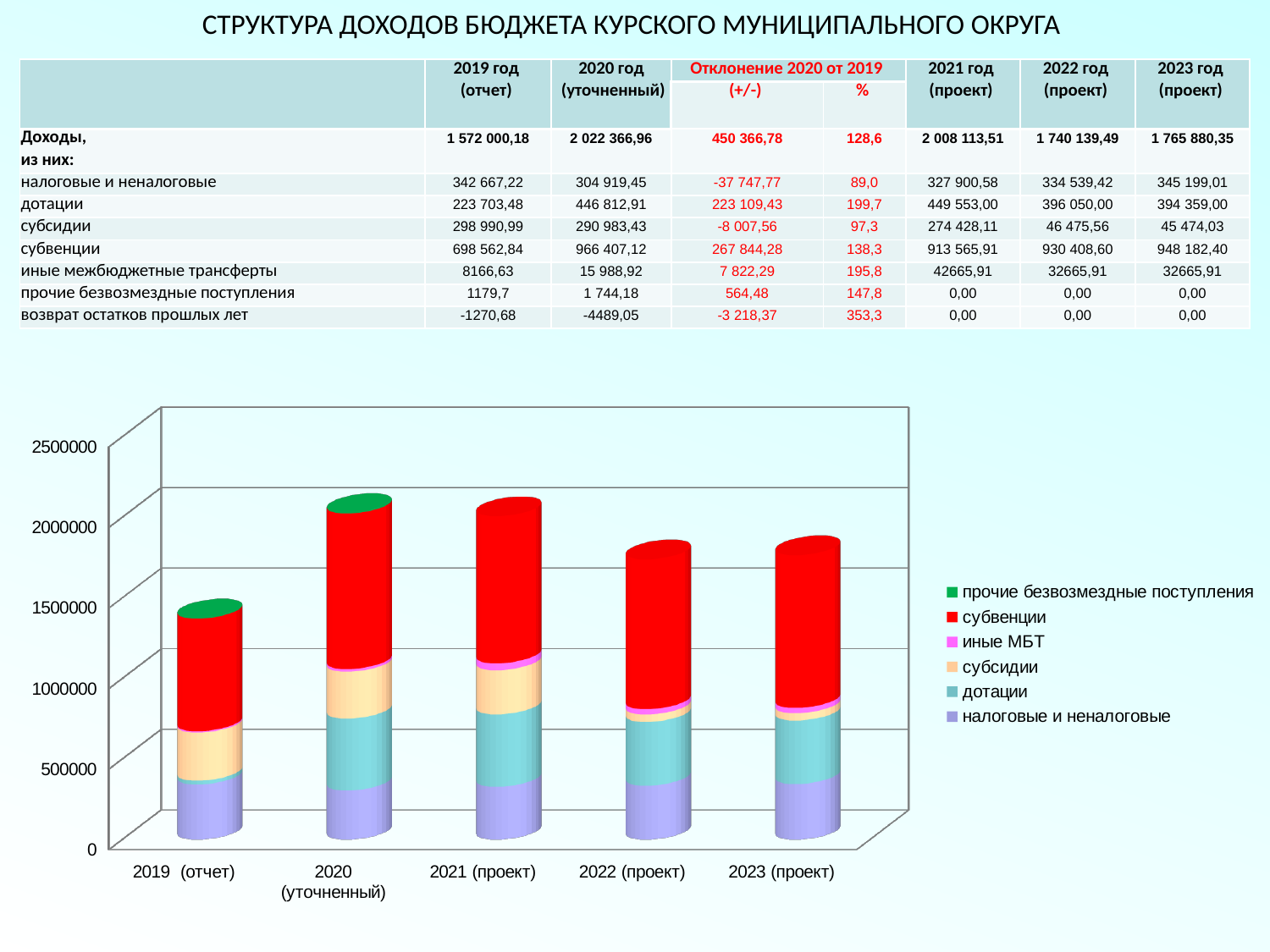
Which series is listed first in the chart legend? прочие безвозмездные поступления Does the total bar rise or fall from 2021 (проект) to 2022 (проект)? fall How many series does the chart legend list? 6 Is the total bar for 2019 (отчет) greater or less than 2000000? less How many year categories are shown along the x axis of the chart? 5 Which total bar is taller, 2019 (отчет) or 2022 (проект)? 2022 (проект) What kind of chart is shown on the slide? bar chart Which total bar is taller, 2021 (проект) or 2023 (проект)? 2021 (проект) Is the total bar for 2022 (проект) greater or less than 1500000? greater Which year has the lowest total bar in the chart? 2019 (отчет) Which series is shown in red in the chart? субвенции Is the total bar for 2023 (проект) greater or less than 2000000? less